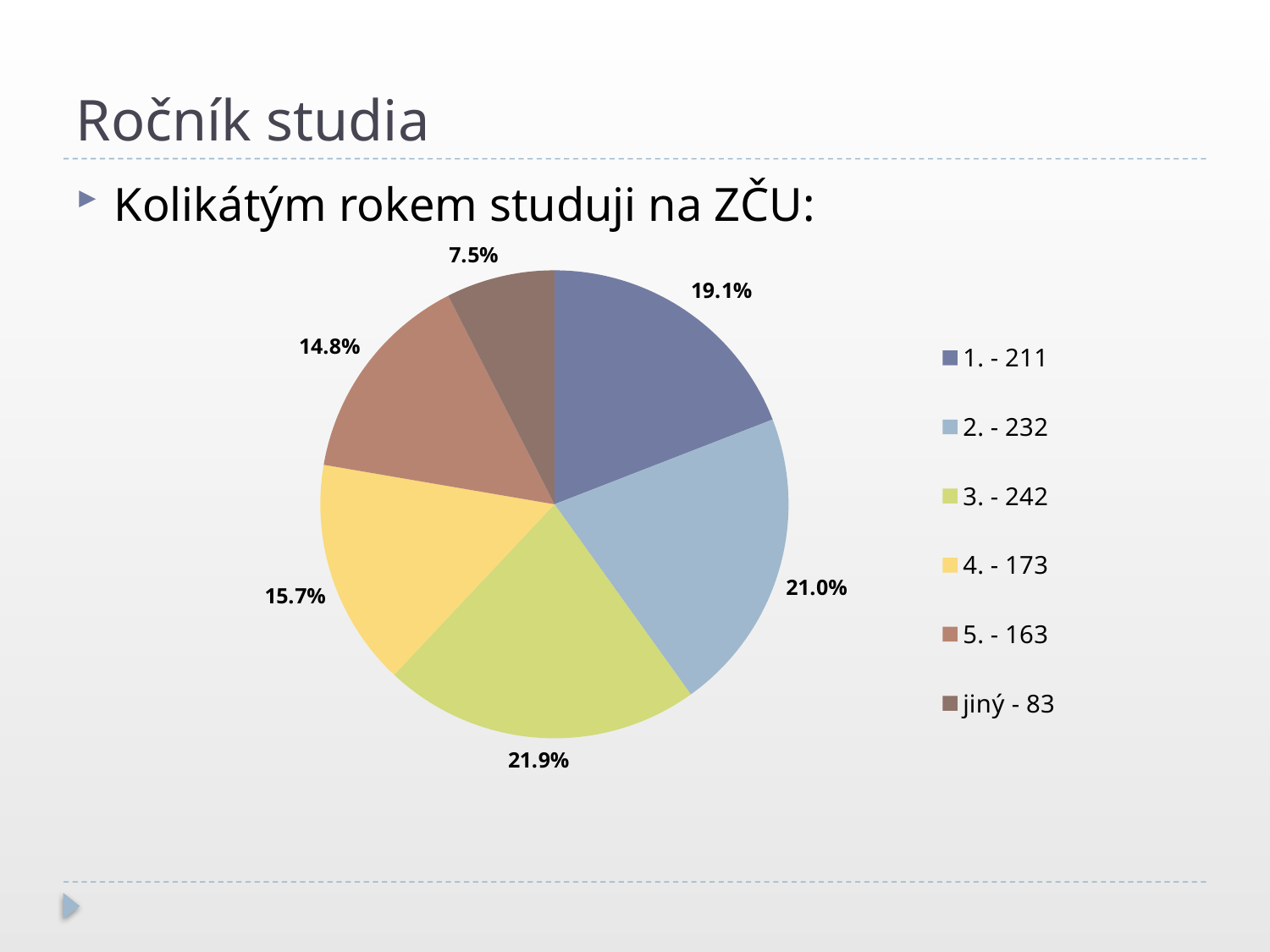
What count is shown in the legend for category "4."? 173 What percentage share does the slice for "1." have in the pie chart? 19.1% What kind of chart is shown on the slide? pie chart What percentage share does the slice for "3." have in the pie chart? 21.9% Which slice is larger, "4." or "5."? 4. Which category has the largest slice in the pie chart? 3. Which category has the smallest slice in the pie chart? jiný What is the difference in percentage points between the slices for "2." and "1."? 1.9 What percentage share does the slice for "jiný" have in the pie chart? 7.5% How many categories does the pie chart show? 6 What count is shown in the legend for category "2."? 232